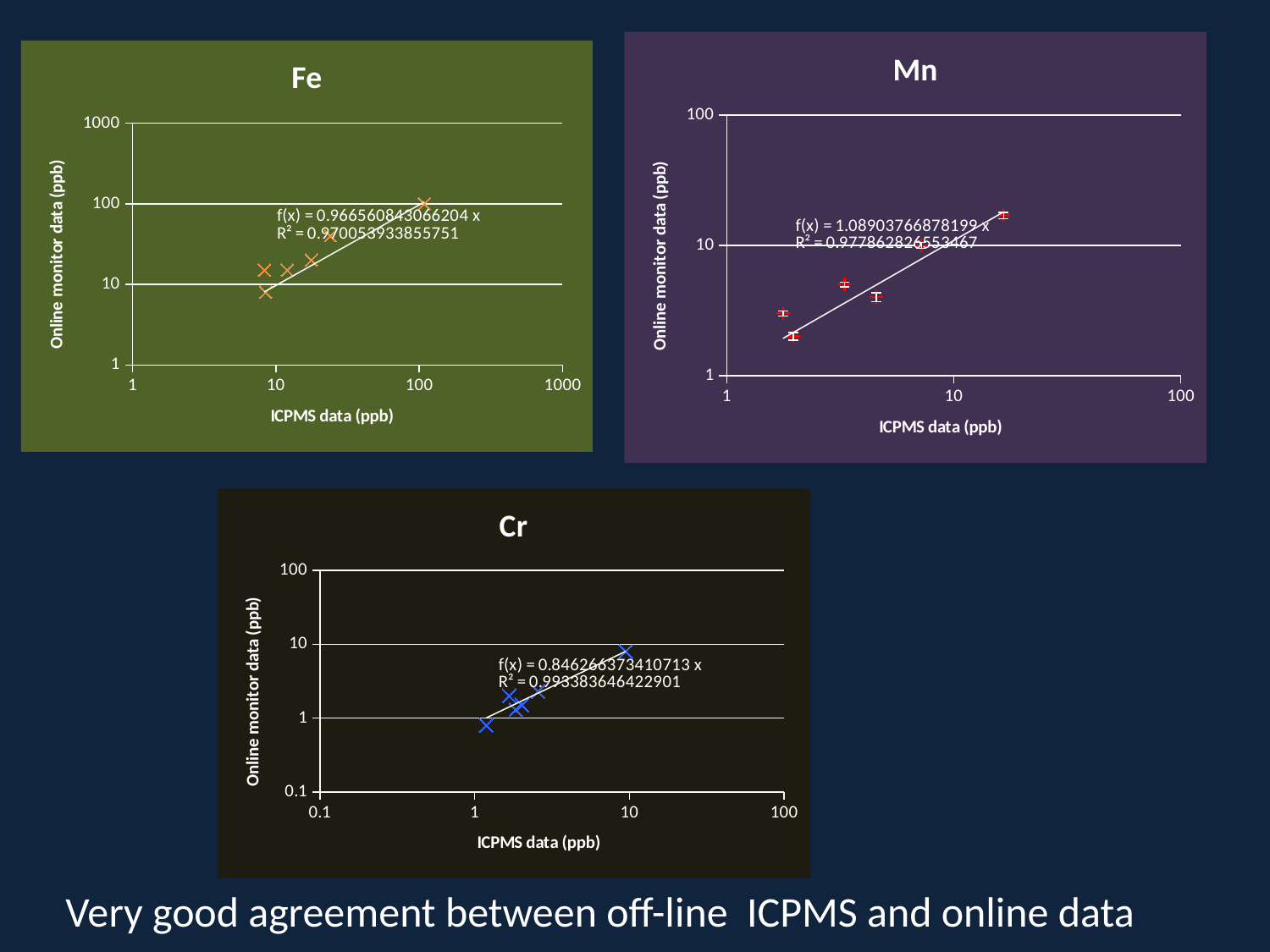
On the Cr chart, is the online monitor value of the lowest data point greater or less than 1? less On the Cr chart, what is the R² value printed for the trendline? 0.993383646422901 Is the printed R² value on the Mn chart larger or smaller than the printed R² value on the Fe chart? larger Which of the three charts (Fe, Mn, Cr) has the highest printed R² value? Cr What is the label of the x axis on the Fe chart? ICPMS data (ppb) On the Cr chart, what is the slope coefficient in the printed trendline equation f(x)? 0.846266373410713 On the Mn chart, what is the slope coefficient in the printed trendline equation f(x)? 1.08903766878199 On the Cr chart, how many data points are plotted? 6 What kind of chart is the Fe chart? scatter chart Which of the three charts (Fe, Mn, Cr) has the lowest printed R² value? Fe On the Fe chart, what is the R² value printed for the trendline? 0.970053933855751 On the Mn chart, do the online monitor values rise or fall as the ICPMS data increases along the x axis? rise